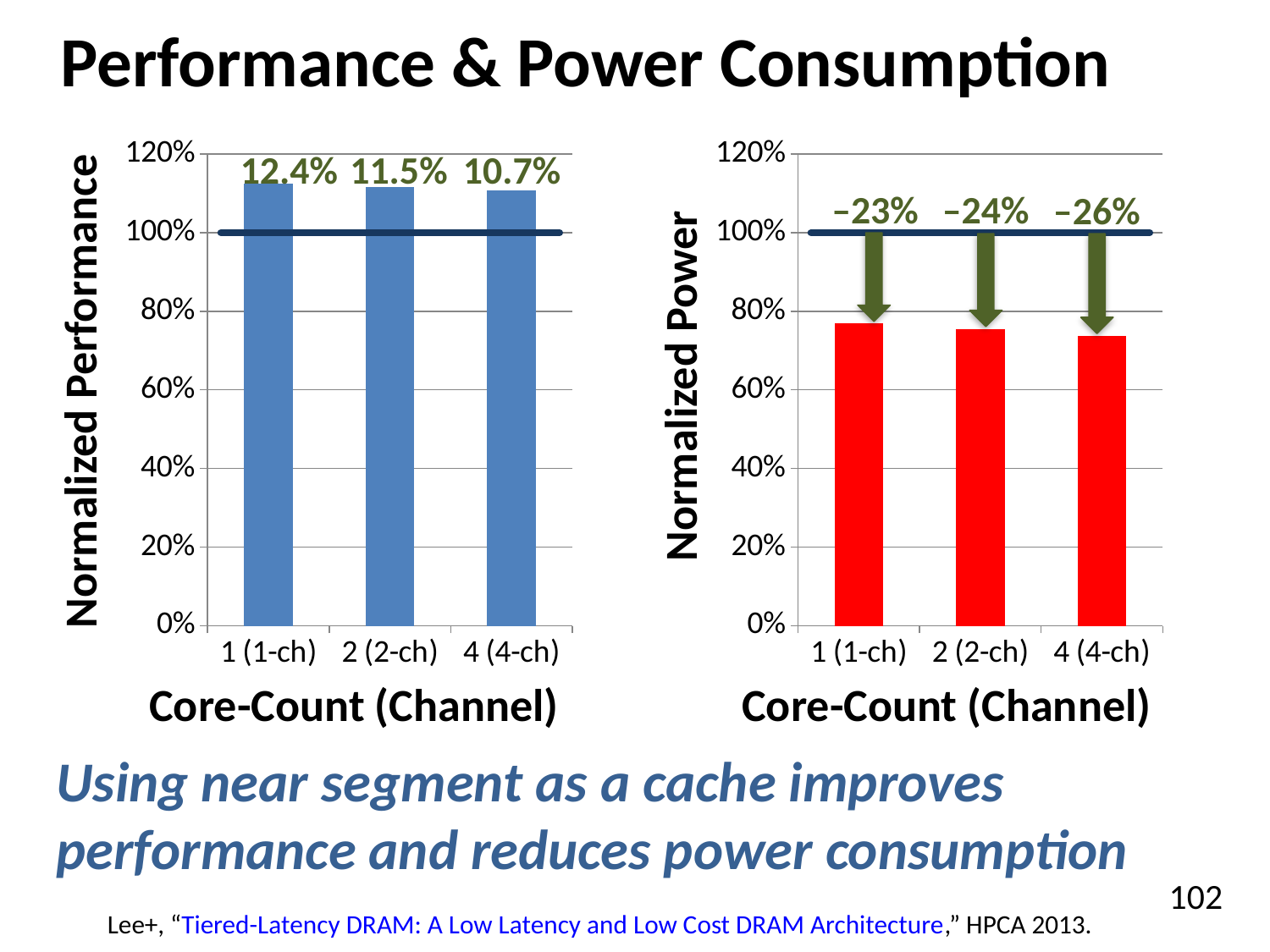
On the Normalized Power chart, which core-count category has the largest power reduction label? 4 (4-ch) On the Normalized Power chart, what power reduction label is shown above the 4 (4-ch) bar? –26% What colour are the bars on the Normalized Power chart? red On the Normalized Power chart, is the value for 1 (1-ch) greater or less than 80%? less On the Normalized Performance chart, do the performance improvement labels rise or fall as the core count increases from 1 to 4? fall On the Normalized Performance chart, which core-count category has the largest performance improvement label? 1 (1-ch) How many core-count categories are shown on the Normalized Power chart on the right? 3 On the Normalized Performance chart, is the value for 2 (2-ch) greater or less than 100%? greater On the Normalized Power chart, what power reduction label is shown above the 2 (2-ch) bar? –24% On the Normalized Performance chart, what performance improvement label is shown above the 1 (1-ch) bar? 12.4% On the Normalized Performance chart, what performance improvement label is shown above the 4 (4-ch) bar? 10.7% What kind of chart is the Normalized Performance chart on the left? bar chart